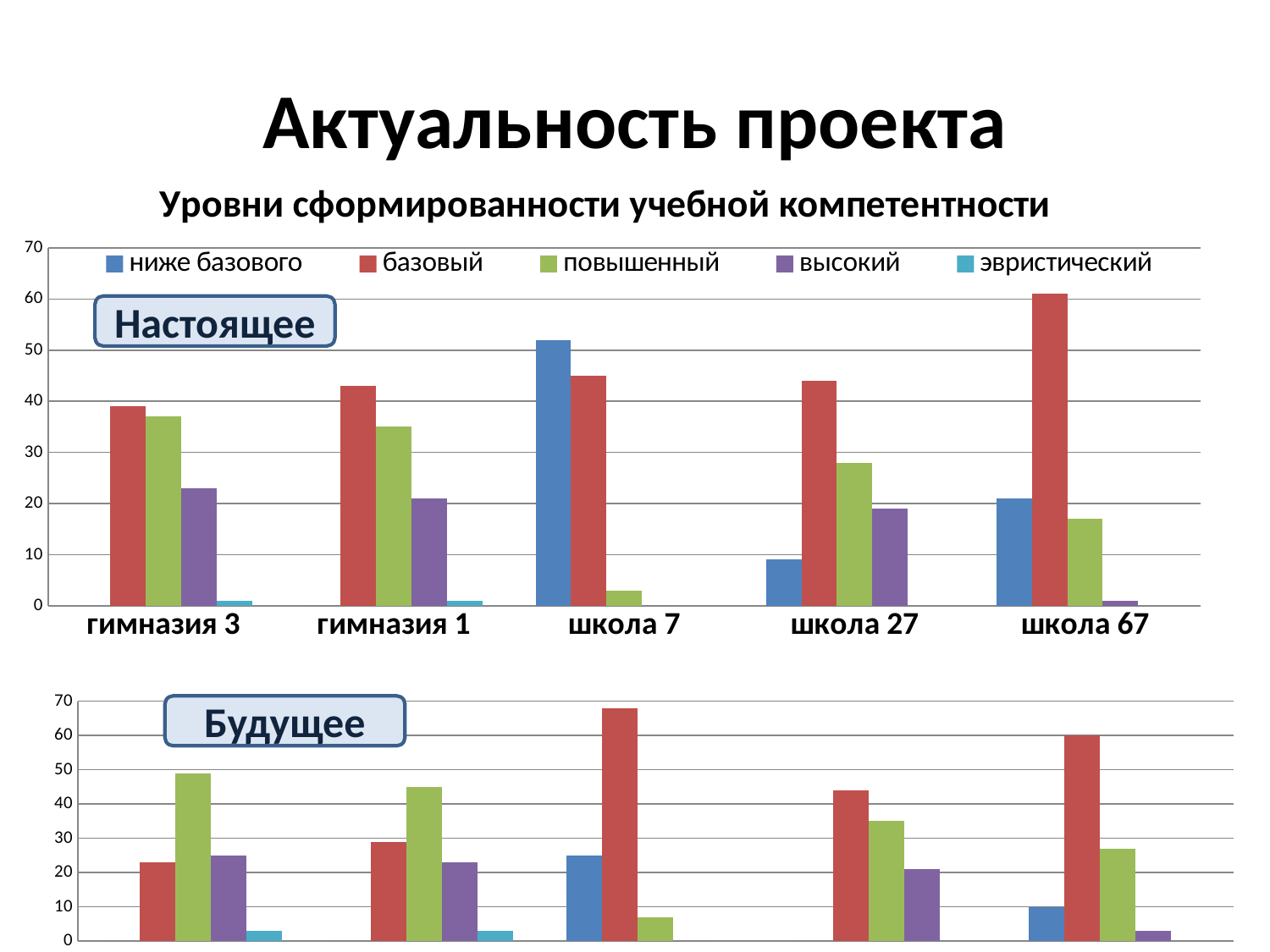
In the top chart "Настоящее", which category has the lowest "повышенный" bar? школа 7 In the bottom chart "Будущее", which series has the tallest bar in the first group of bars? повышенный In the top chart "Настоящее", which is larger: the "ниже базового" value for школа 7 or for школа 27? школа 7 In the top chart "Настоящее", is the "ниже базового" value for школа 7 greater or less than 50? greater What is the label in the box on the bottom chart? Будущее In the bottom chart "Будущее", is the tallest "базовый" bar (third group) greater or less than 60? greater What kind of chart is the top chart labelled "Настоящее"? bar chart In the top chart "Настоящее", which category has the highest "базовый" bar? школа 67 In the top chart "Настоящее", which is larger: the "базовый" value for школа 67 or for гимназия 3? школа 67 How many series does the legend of the top chart "Настоящее" list? 5 How many categories (schools) are shown on the x axis of the top chart "Настоящее"? 5 In the top chart "Настоящее", is the "повышенный" value for школа 67 greater or less than 20? less